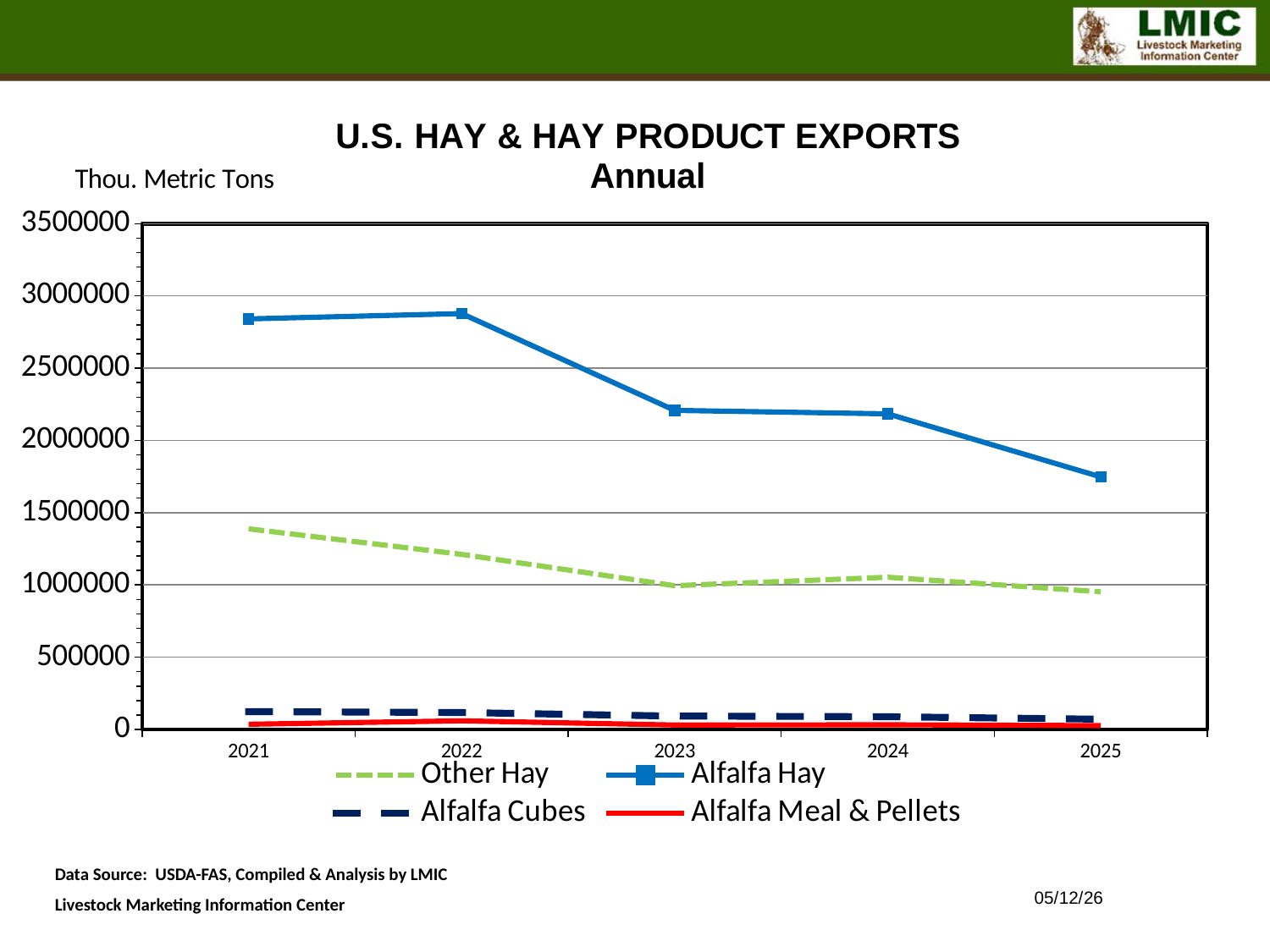
Is the Alfalfa Hay value for 2025 greater or less than 2000000? less In which year is the Other Hay value highest? 2021 Which is larger in 2023, Alfalfa Hay or Other Hay? Alfalfa Hay Which series has the lowest values across all years? Alfalfa Meal & Pellets How many series does the legend list? 4 In which year is the Alfalfa Hay value lowest? 2025 Is the Other Hay value for 2021 greater or less than 1000000? greater What unit is shown for the y axis? Thou. Metric Tons How many years are plotted along the x axis? 5 Is the Alfalfa Hay value for 2021 greater or less than 2500000? greater What kind of chart is shown on the slide? line chart Which series has the highest values across all years? Alfalfa Hay